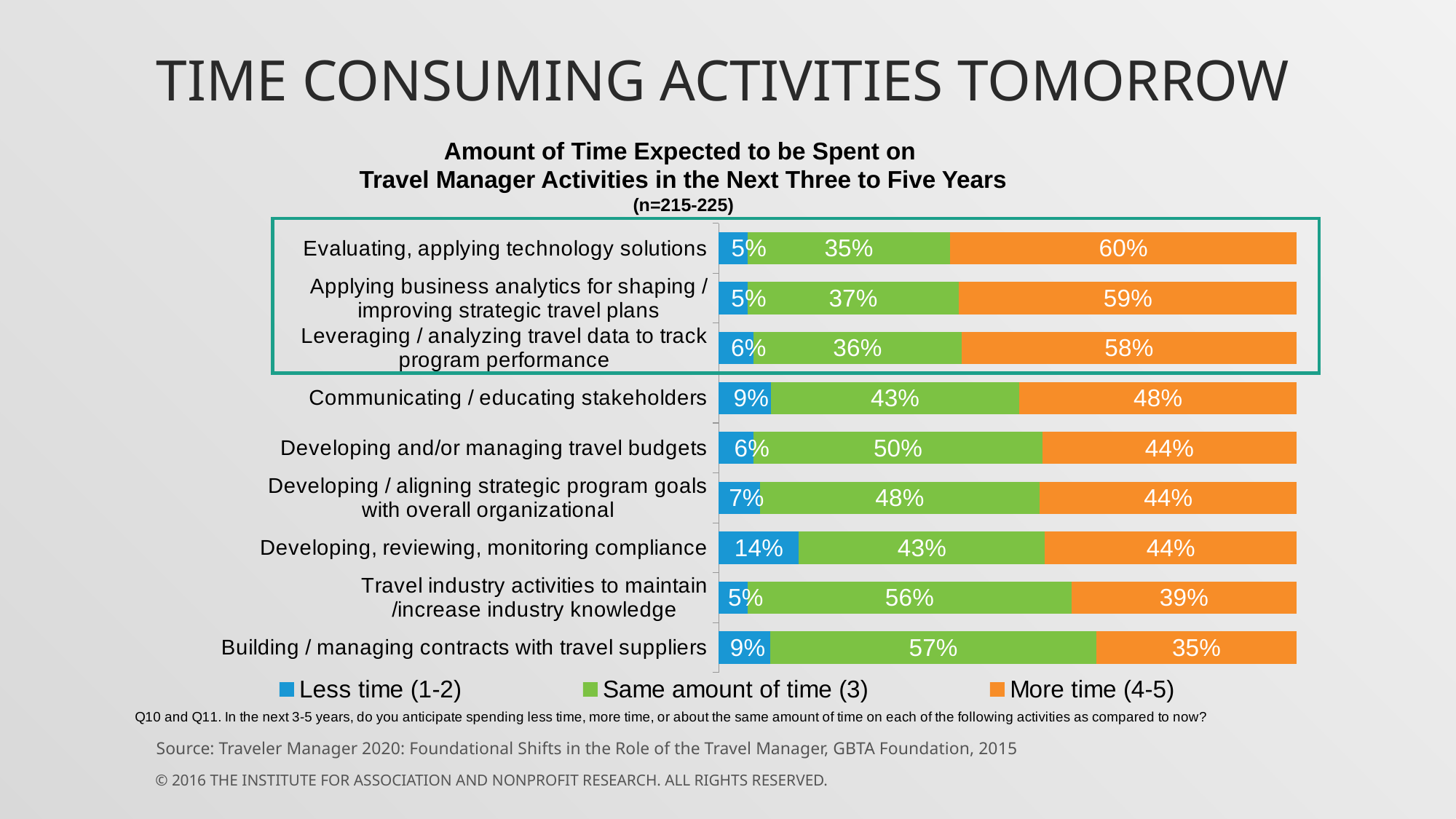
What kind of chart is shown on the slide? Stacked bar chart Which has a larger 'Same amount of time (3)' value: developing and/or managing travel budgets or communicating / educating stakeholders? Developing and/or managing travel budgets How many series does the legend list? 3 What is the 'Same amount of time (3)' value for building / managing contracts with travel suppliers? 57% What is the 'Less time (1-2)' value for developing, reviewing, monitoring compliance? 14% What is the sample size shown under the chart title? n=215-225 What percentage of respondents expect to spend more time on evaluating, applying technology solutions? 60% Which activity has the highest 'Less time (1-2)' percentage? Developing, reviewing, monitoring compliance Which activity has the lowest 'More time (4-5)' percentage? Building / managing contracts with travel suppliers What is the difference between the 'More time (4-5)' values for evaluating, applying technology solutions and building / managing contracts with travel suppliers? 25% How many activities are shown in the chart? 9 Which activity has the highest 'More time (4-5)' percentage? Evaluating, applying technology solutions